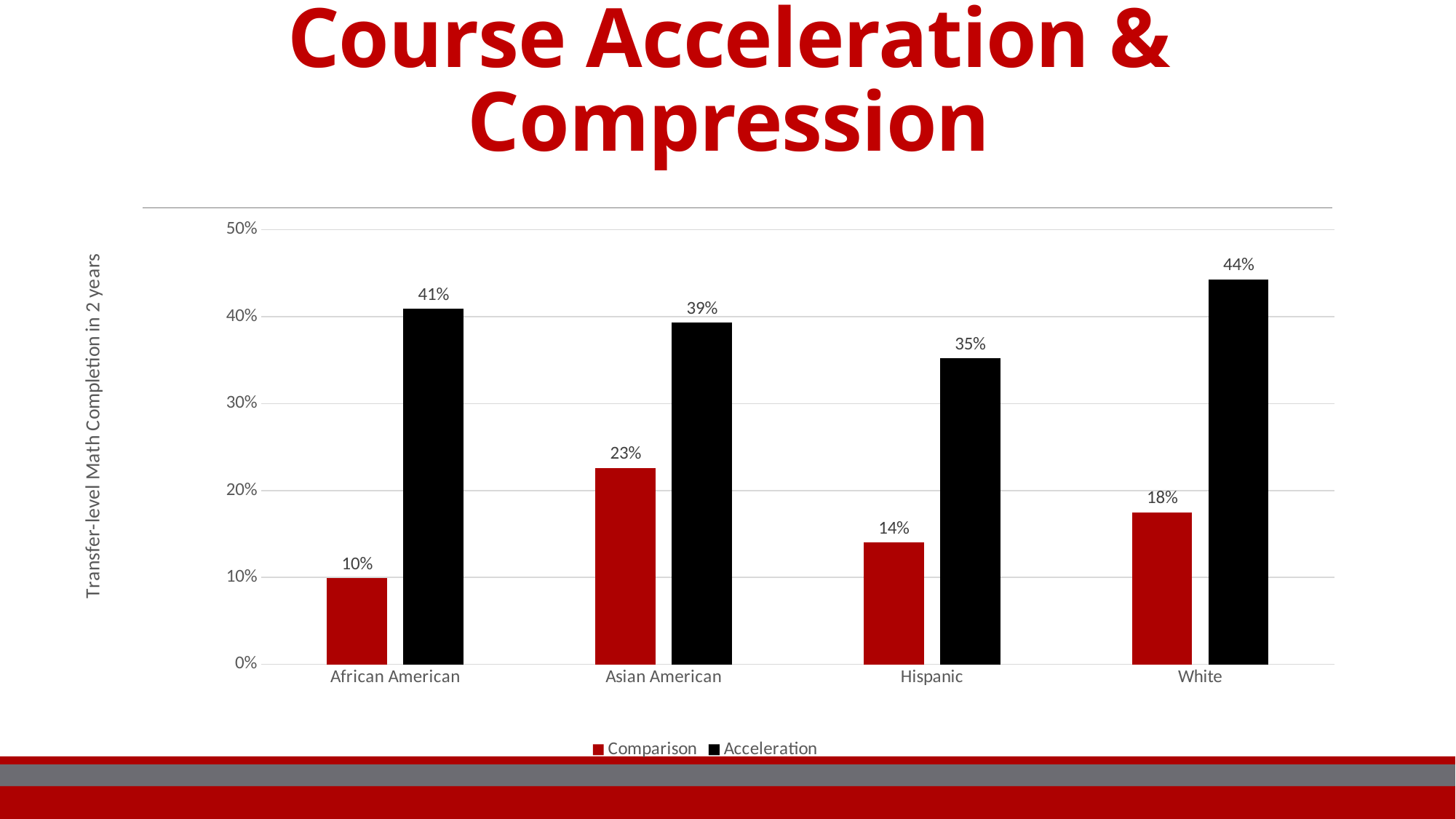
How many series does the legend list? 2 What is the Acceleration value for African American? 41% Which colour represents the Acceleration series? Black Which category has the lowest Comparison value? African American What is the y-axis label of the chart? Transfer-level Math Completion in 2 years What kind of chart is shown on the slide? Bar chart How many categories are shown on the x axis? 4 Which is larger, the Acceleration value for Hispanic or the Acceleration value for Asian American? Asian American Which category has the highest Acceleration value? White What is the Comparison value for Asian American? 23% What is the difference between the Acceleration and Comparison values for White? 26% What is the Comparison value for Hispanic? 14%